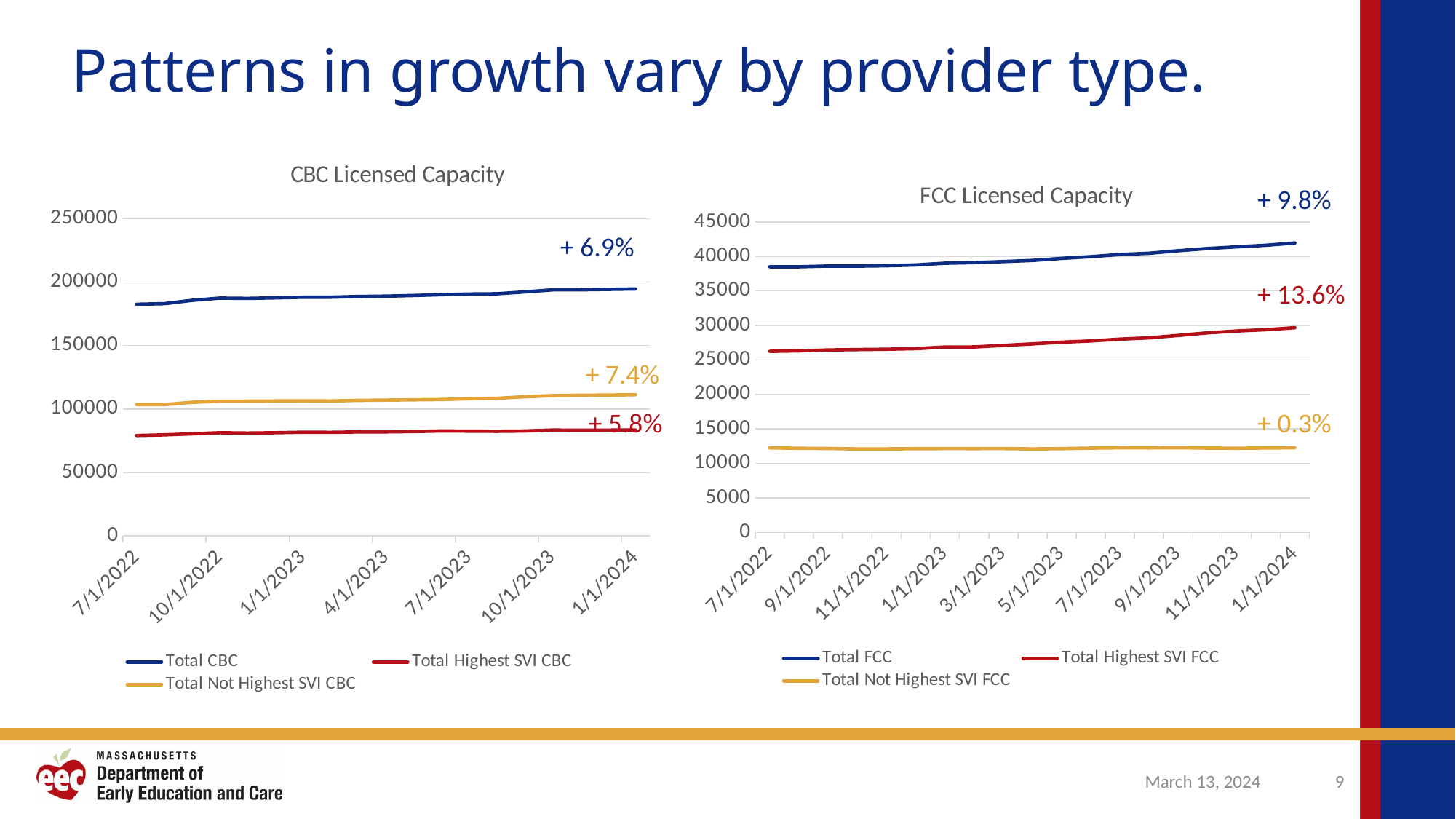
In the CBC Licensed Capacity chart, what growth percentage is annotated for the Total Not Highest SVI CBC line? + 7.4% In the FCC Licensed Capacity chart, what growth percentage is annotated for the Total Highest SVI FCC line? + 13.6% In the FCC Licensed Capacity chart, which series has the highest annotated growth percentage? Total Highest SVI FCC How many series does the legend of the FCC Licensed Capacity chart list? 3 In the CBC Licensed Capacity chart, is the value for Total CBC on 1/1/2024 greater or less than 150000? greater In the FCC Licensed Capacity chart, does the Total FCC line rise or fall from 7/1/2022 to 1/1/2024? rise In the CBC Licensed Capacity chart, what growth percentage is annotated for the Total CBC line? + 6.9% What type of chart is the CBC Licensed Capacity chart? line chart In the CBC Licensed Capacity chart, which series has the lowest annotated growth percentage? Total Highest SVI CBC In the CBC Licensed Capacity chart, which series is plotted highest on the chart? Total CBC In the FCC Licensed Capacity chart, is the value for Total Not Highest SVI FCC on 1/1/2024 greater or less than 15000? less In the FCC Licensed Capacity chart, what growth percentage is annotated for the Total Not Highest SVI FCC line? + 0.3%